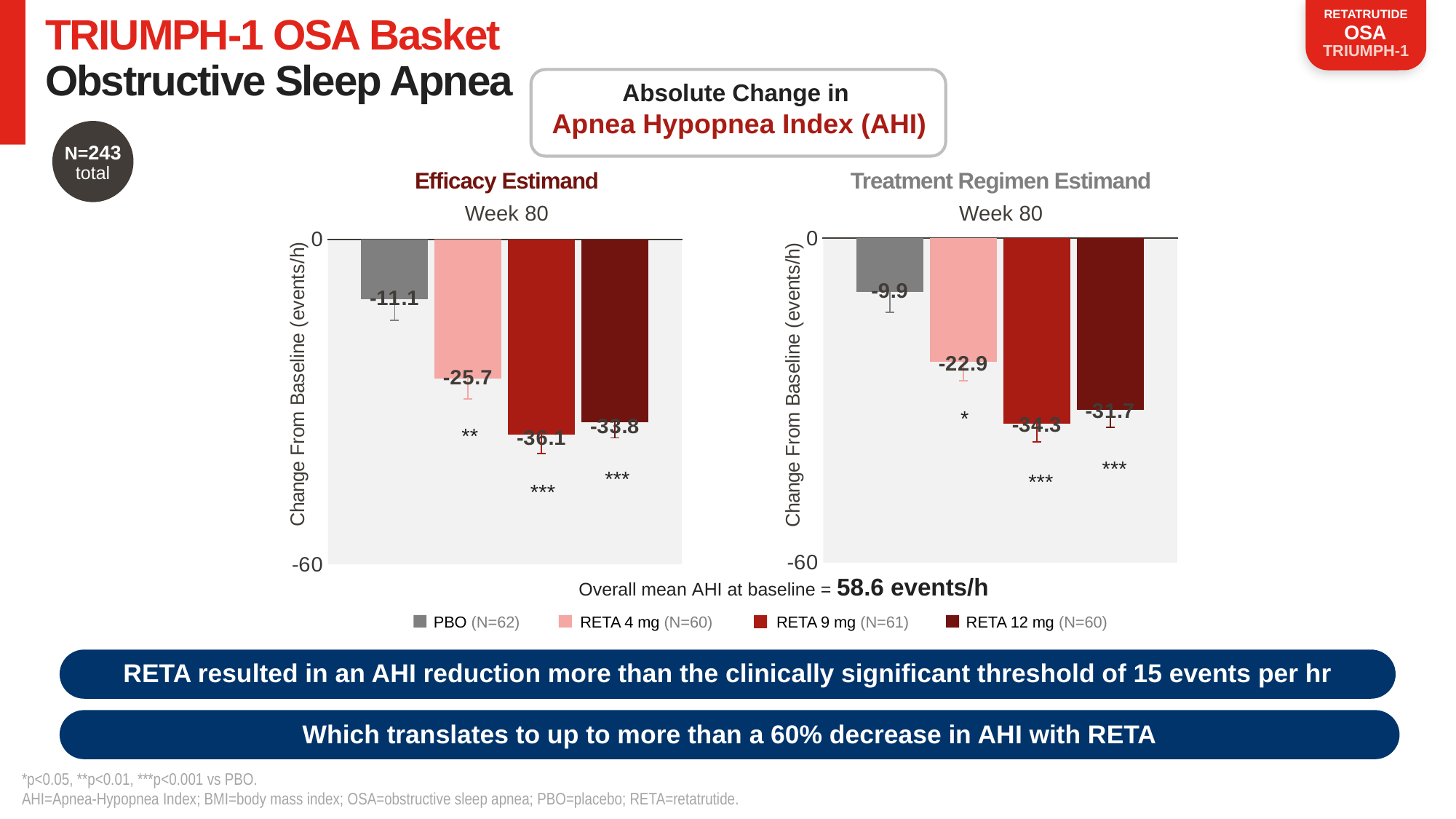
In the Treatment Regimen Estimand chart, what is the difference between the RETA 9 mg value and the RETA 12 mg value? 2.6 What type of chart is used for the Efficacy Estimand? Bar chart In the Efficacy Estimand chart, what is the difference between the RETA 4 mg value and the PBO value? 14.6 In the Treatment Regimen Estimand chart, which group shows the smallest change from baseline? PBO In the Treatment Regimen Estimand chart, what is the change from baseline for RETA 4 mg? -22.9 How many series does the legend list? 4 In the Treatment Regimen Estimand chart, what is the change from baseline for RETA 12 mg? -31.7 In the Treatment Regimen Estimand chart, which shows a larger reduction from baseline, RETA 4 mg or RETA 9 mg? RETA 9 mg In the Efficacy Estimand chart, what is the change from baseline for RETA 9 mg? -36.1 In the Efficacy Estimand chart, what is the change from baseline for PBO? -11.1 In the Efficacy Estimand chart, which group shows the largest reduction from baseline? RETA 9 mg How many bars are shown in the Efficacy Estimand chart? 4